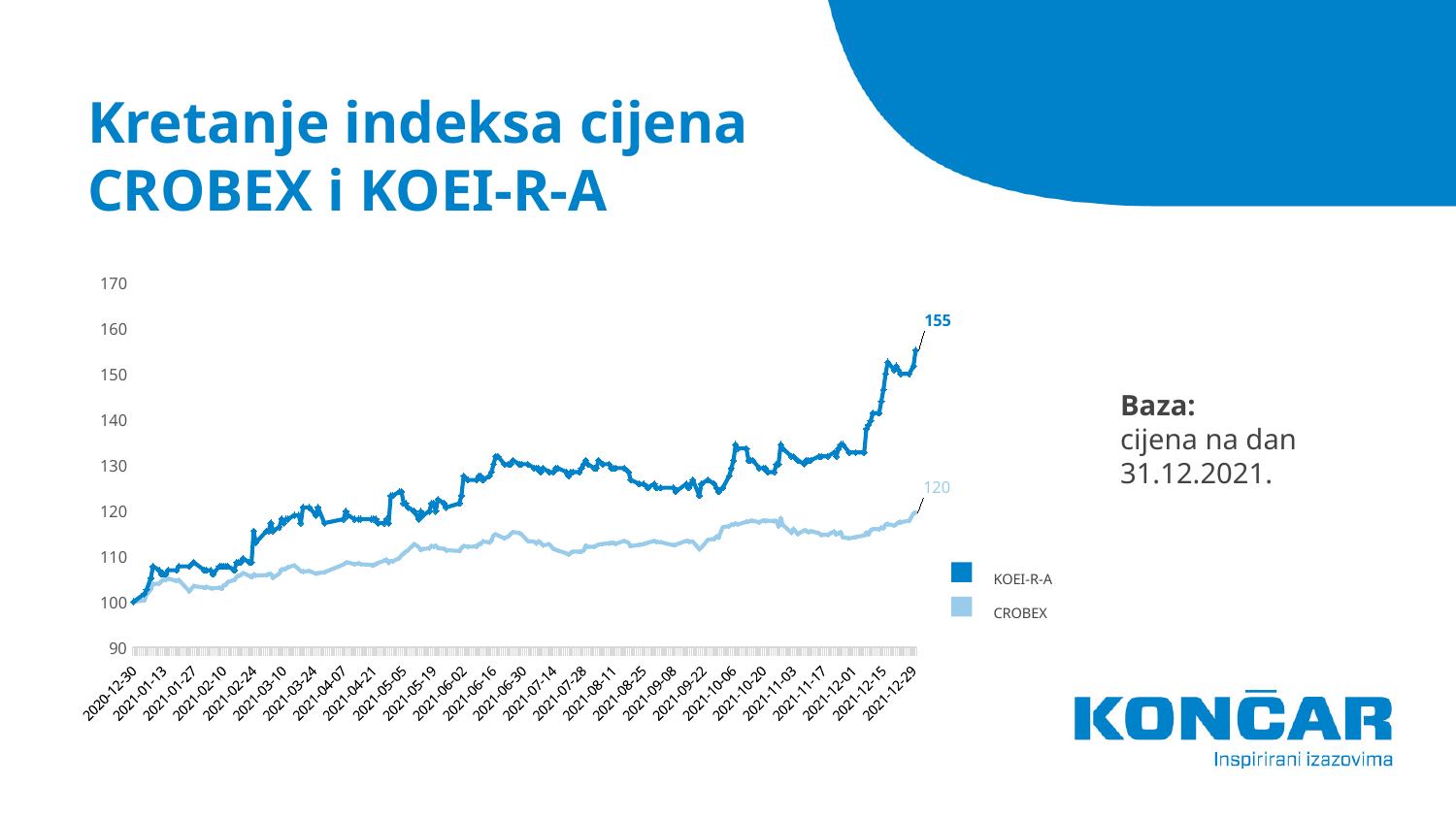
What is the difference between the final labelled values of KOEI-R-A (155) and CROBEX (120)? 35 What kind of chart is shown on the slide? Line chart How many series does the legend list? 2 At what value do both series start on 2020-12-30? 100 Do the KOEI-R-A values generally rise or fall from 2020-12-30 to 2021-12-29? Rise Which series reaches the highest value on the chart? KOEI-R-A What is the data label shown at the end of the KOEI-R-A line? 155 Is the value of CROBEX around 2021-06-16 greater or less than 120? less What is the title of the chart on the slide? Kretanje indeksa cijena CROBEX i KOEI-R-A What is the data label shown at the end of the CROBEX line? 120 Is the value of KOEI-R-A around 2021-06-16 greater or less than 120? greater Which series has the higher value at the end of the period, KOEI-R-A or CROBEX? KOEI-R-A